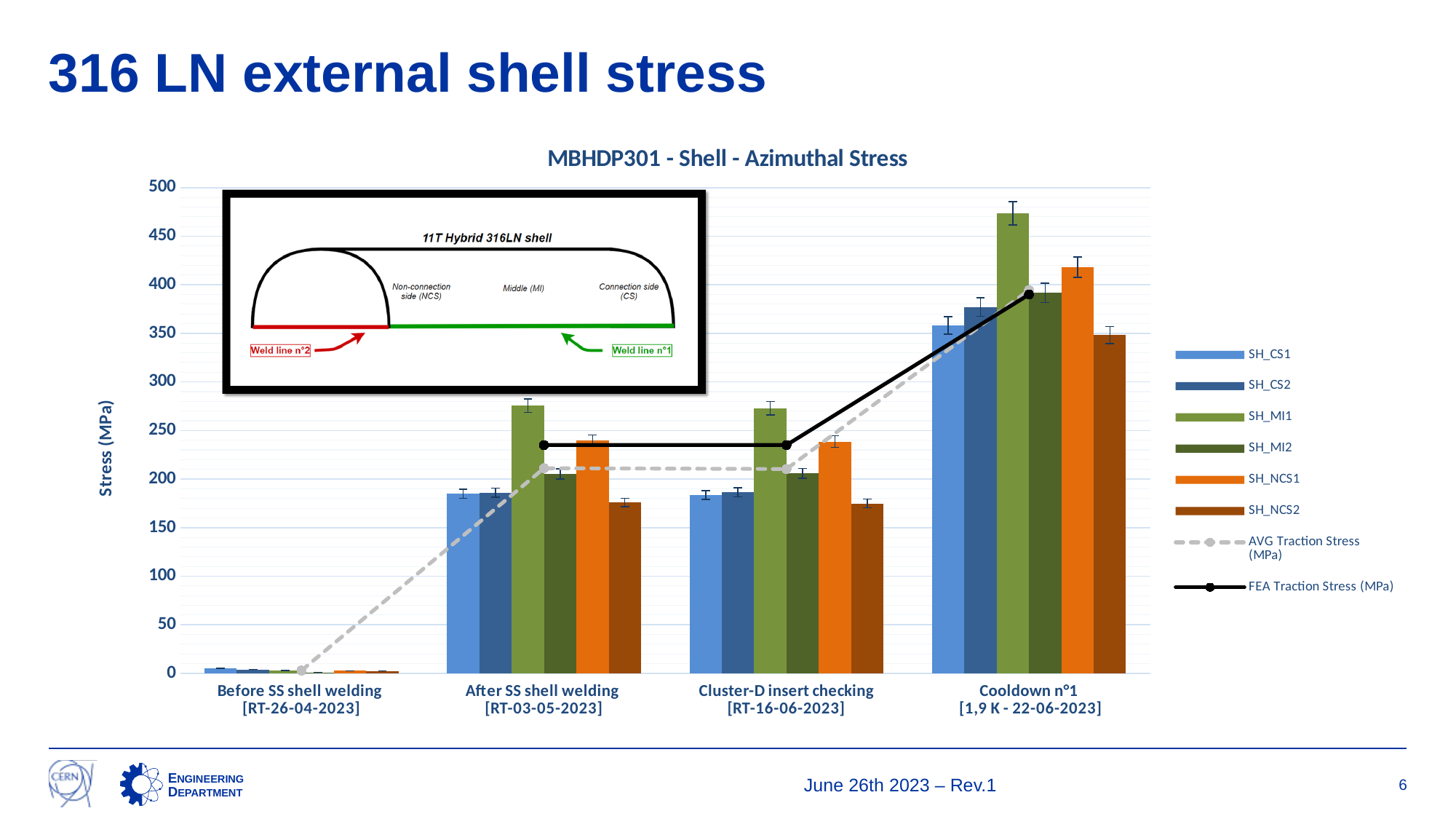
Which series has the highest bar in the Cooldown n°1 category? SH_MI1 How many categories are shown along the x axis of the chart? 4 Is the value for SH_MI1 in the Cooldown n°1 category greater or less than 450? greater Does the AVG Traction Stress (MPa) line rise or fall from the first category to the last? rises How many series does the chart legend list? 8 Is the value for SH_NCS1 in the After SS shell welding category greater or less than 200? greater What kind of chart is shown on the slide? bar and line chart What is the title of the chart? MBHDP301 - Shell - Azimuthal Stress Which category has the highest stress values overall? Cooldown n°1 Which series has the lowest bar in the Cooldown n°1 category? SH_NCS2 Is the value for SH_NCS2 in the Cluster-D insert checking category greater or less than 200? less In the Cluster-D insert checking category, which is larger: SH_MI1 or SH_NCS1? SH_MI1